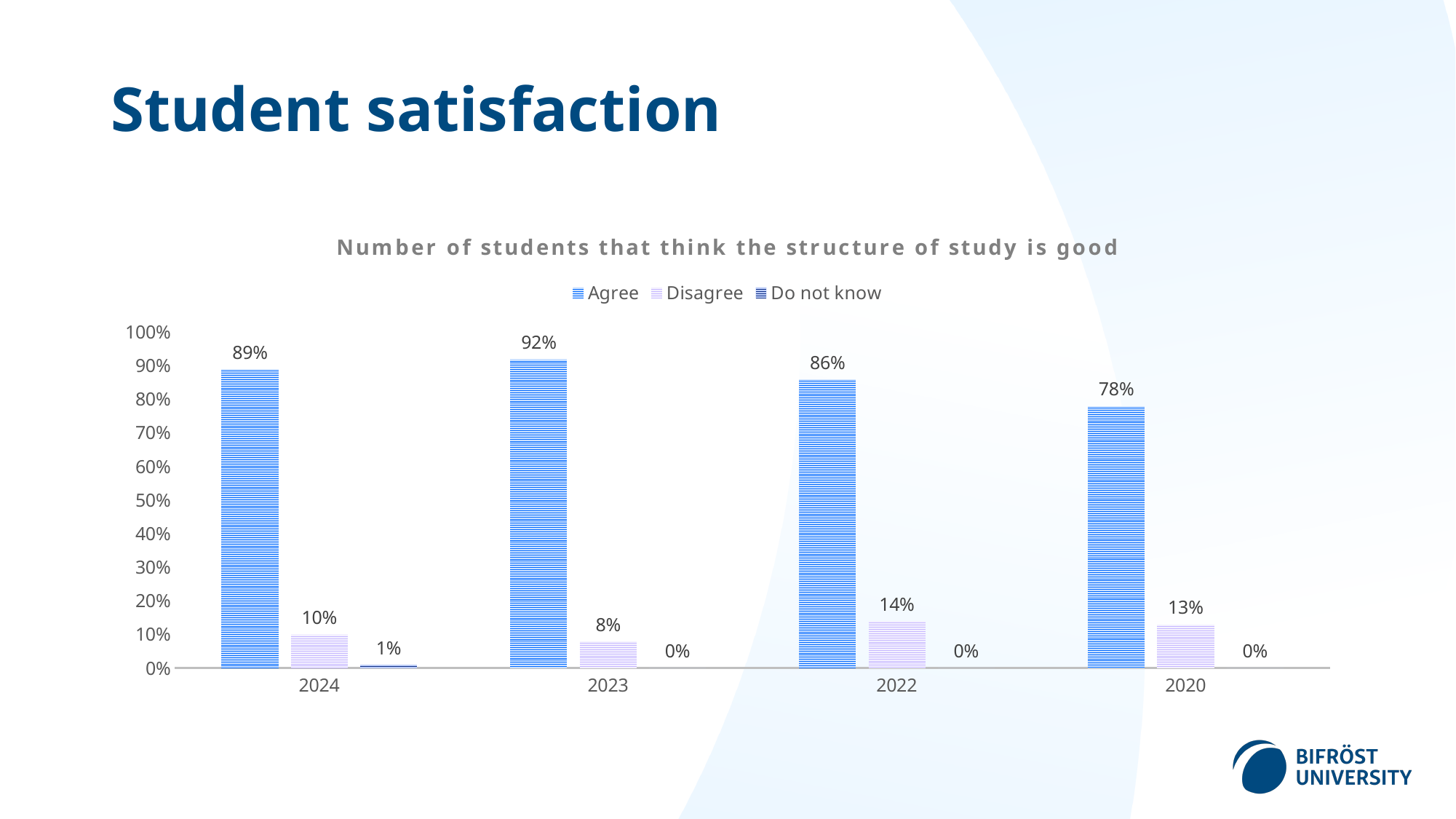
How many years are shown on the x axis? 4 Which year has the lowest Agree value? 2020 Which year has the highest Agree value? 2023 What is the Do not know value for 2024? 1% What is the Agree value for 2020? 78% What kind of chart is shown on the slide? Bar chart What is the title of the chart? Number of students that think the structure of study is good What is the difference between the Agree values for 2023 and 2020? 14% Which is larger, the Disagree value for 2022 or the Disagree value for 2023? 2022 How many series does the legend list? 3 What is the Disagree value for 2022? 14% What is the Agree value for 2024? 89%